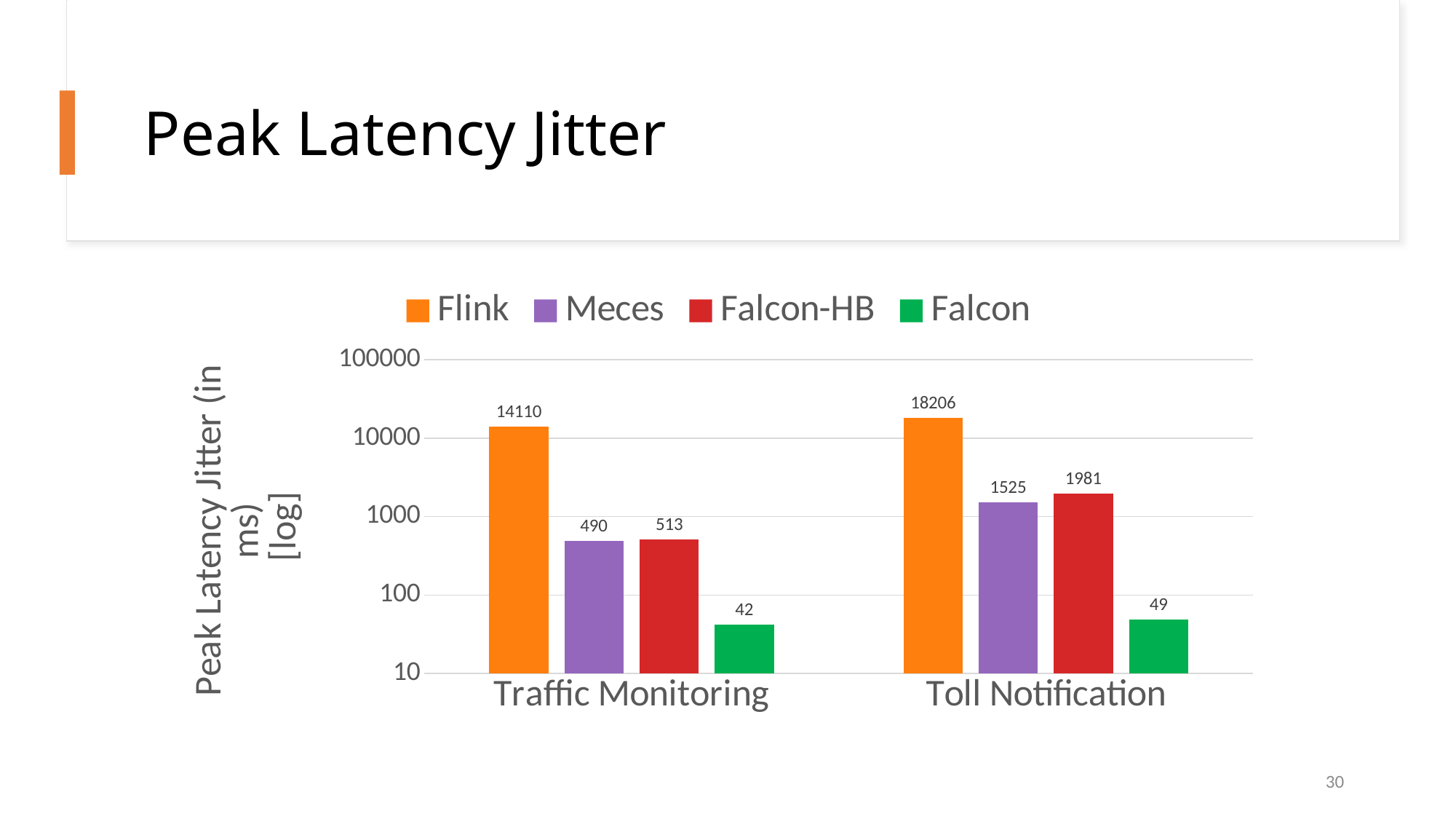
Which is larger: Falcon-HB's peak latency jitter in Toll Notification or Meces's in Toll Notification? Falcon-HB What is the peak latency jitter for Meces in Toll Notification? 1525 What is the y-axis label of the chart? Peak Latency Jitter (in ms) [log] How many series does the legend list? 4 What is the peak latency jitter for Flink in Traffic Monitoring? 14110 What is the peak latency jitter for Falcon in Toll Notification? 49 What kind of chart is shown on the slide? Bar chart Which system has the highest peak latency jitter in Toll Notification? Flink Which system has the lowest peak latency jitter in Traffic Monitoring? Falcon What is the difference between Flink's peak latency jitter in Toll Notification and in Traffic Monitoring? 4096 What is the peak latency jitter for Falcon-HB in Traffic Monitoring? 513 Is the value for Falcon in Traffic Monitoring greater or less than 100? less